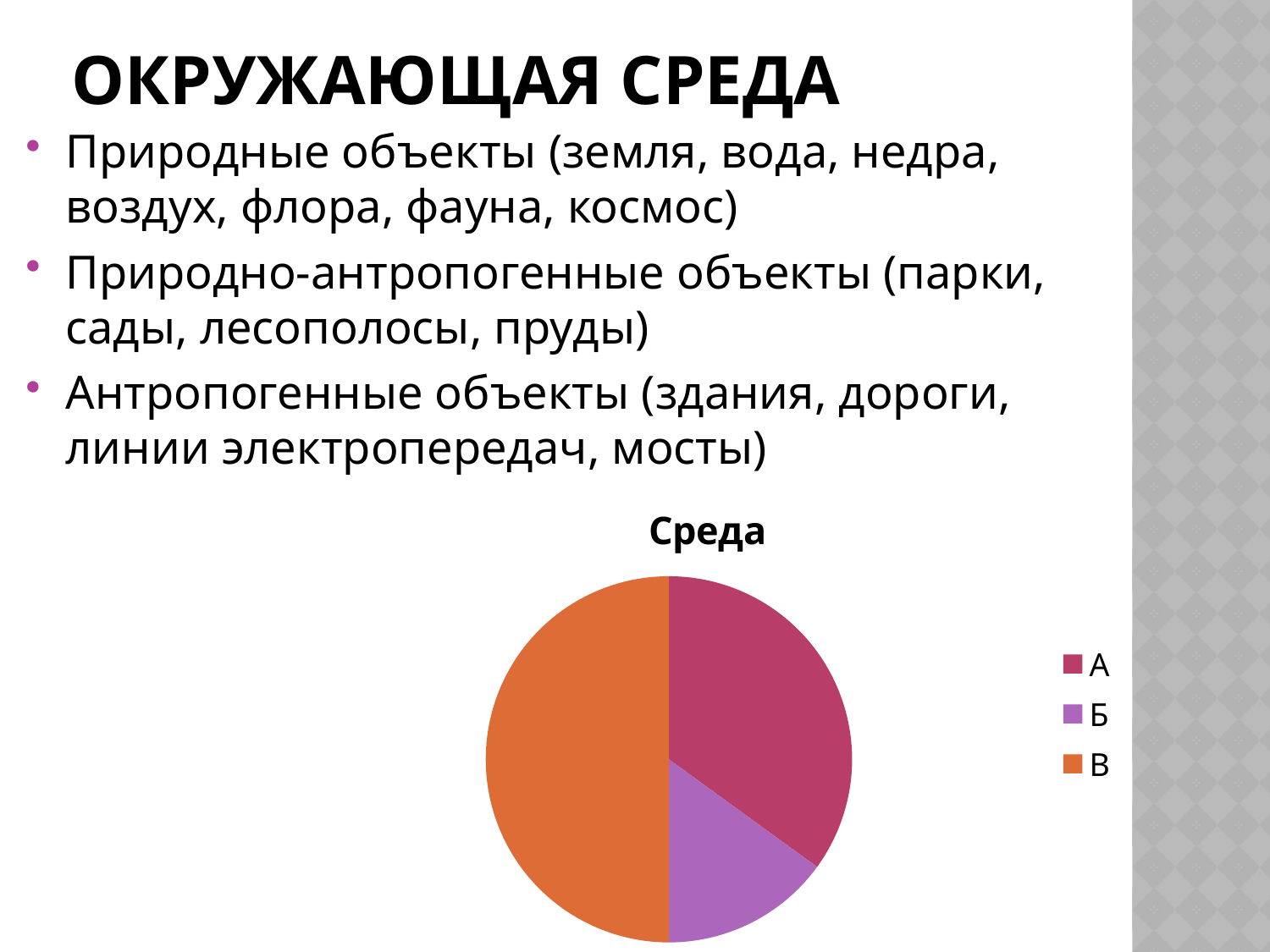
How many entries does the chart legend list? 3 Which category has the smallest slice of the pie? Б What is the title of the chart? Среда Which slice is larger, А or Б? А Which category has the largest slice of the pie? В What kind of chart is shown on the slide? pie chart How many slices does the pie chart have? 3 Which slice is larger, В or А? В What colour is the slice for category В? orange Which slice is larger, В or Б? В